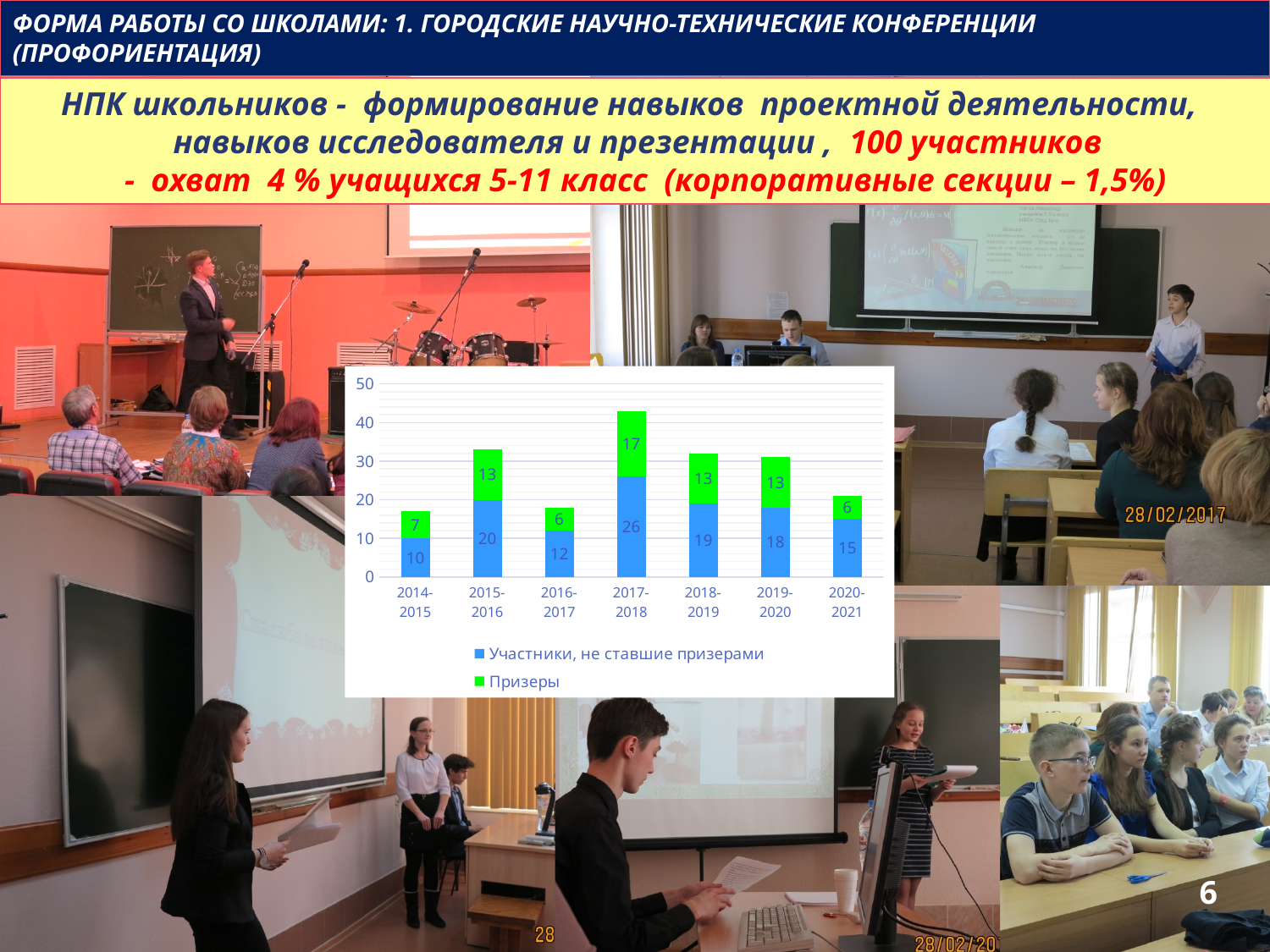
What is the difference between the 'Призеры' values for 2017-2018 and 2016-2017? 11 Which is larger: the 'Участники, не ставшие призерами' value for 2018-2019 or for 2019-2020? 2018-2019 In which academic year is the value for 'Участники, не ставшие призерами' highest? 2017-2018 In which academic year is the value for 'Участники, не ставшие призерами' lowest? 2014-2015 What type of chart is shown on the slide? stacked bar chart What is the total of the stacked bar for 2017-2018? 43 How many series does the chart legend list? 2 What is the value for 'Участники, не ставшие призерами' in 2020-2021? 15 What is the total of the stacked bar for 2014-2015? 17 How many academic years (categories) are shown on the x axis of the chart? 7 What is the value for 'Призеры' in 2017-2018? 17 What is the value for 'Участники, не ставшие призерами' in 2015-2016? 20